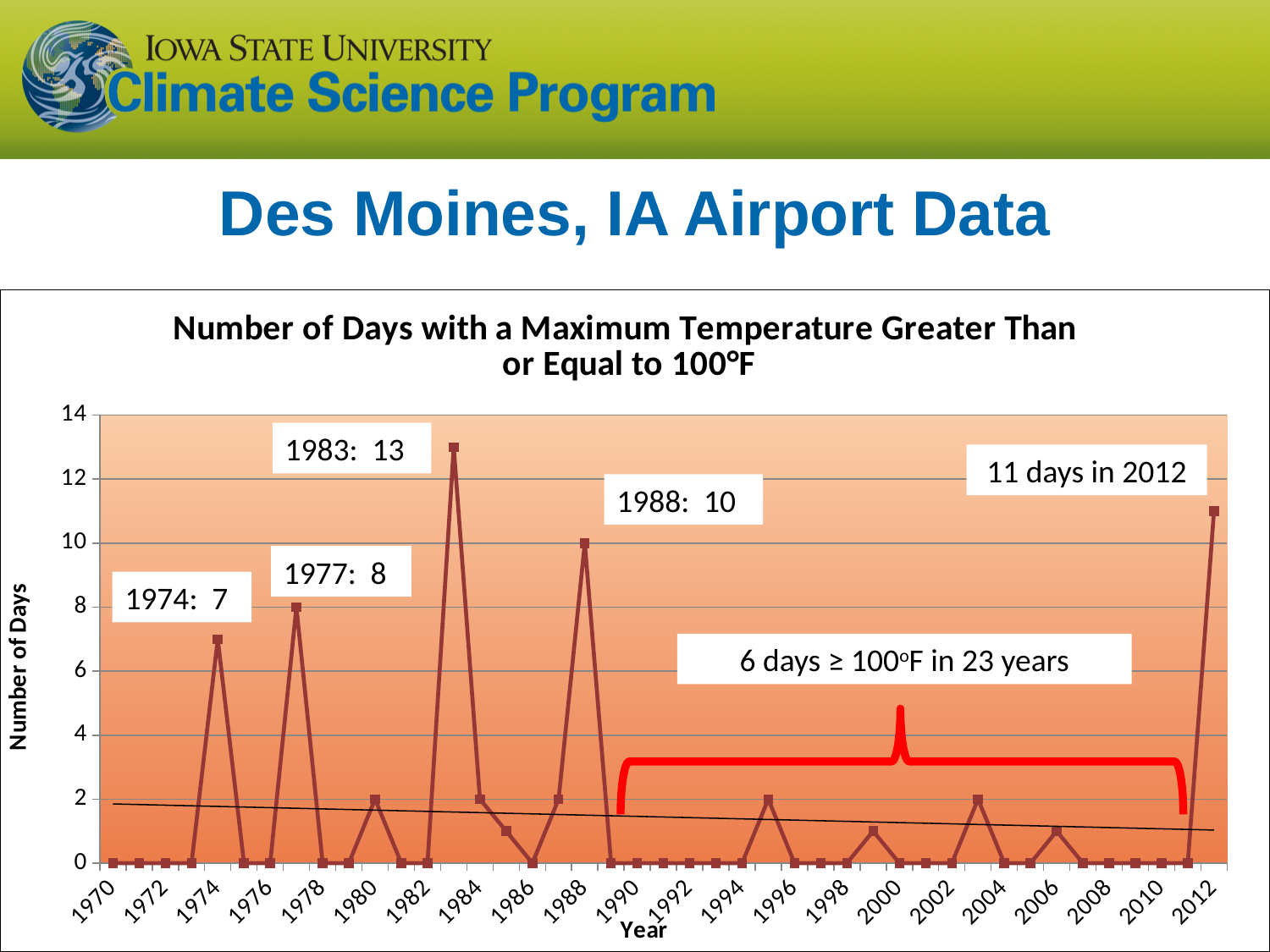
What kind of chart is shown on the slide? line chart Which year has the highest number of days with a maximum temperature of 100°F or more? 1983 How many days with a maximum temperature of 100°F or more were recorded in 1983? 13 How many days with a maximum temperature of 100°F or more were recorded in 1988? 10 Is the value for 1980 greater or less than 6? less How many days with a maximum temperature of 100°F or more were recorded in 1977? 8 How many days with a maximum temperature of 100°F or more were recorded in 2012? 11 What is the difference between the number of days in 2012 and the number of days in 1974? 4 What is the difference between the number of days in 1983 and the number of days in 1988? 3 Which year had more days at or above 100°F, 1974 or 1977? 1977 What is the label on the vertical axis of the chart? Number of Days According to the annotation on the chart, how many days at or above 100°F occurred in the 23-year span from 1989 to 2011? 6 days